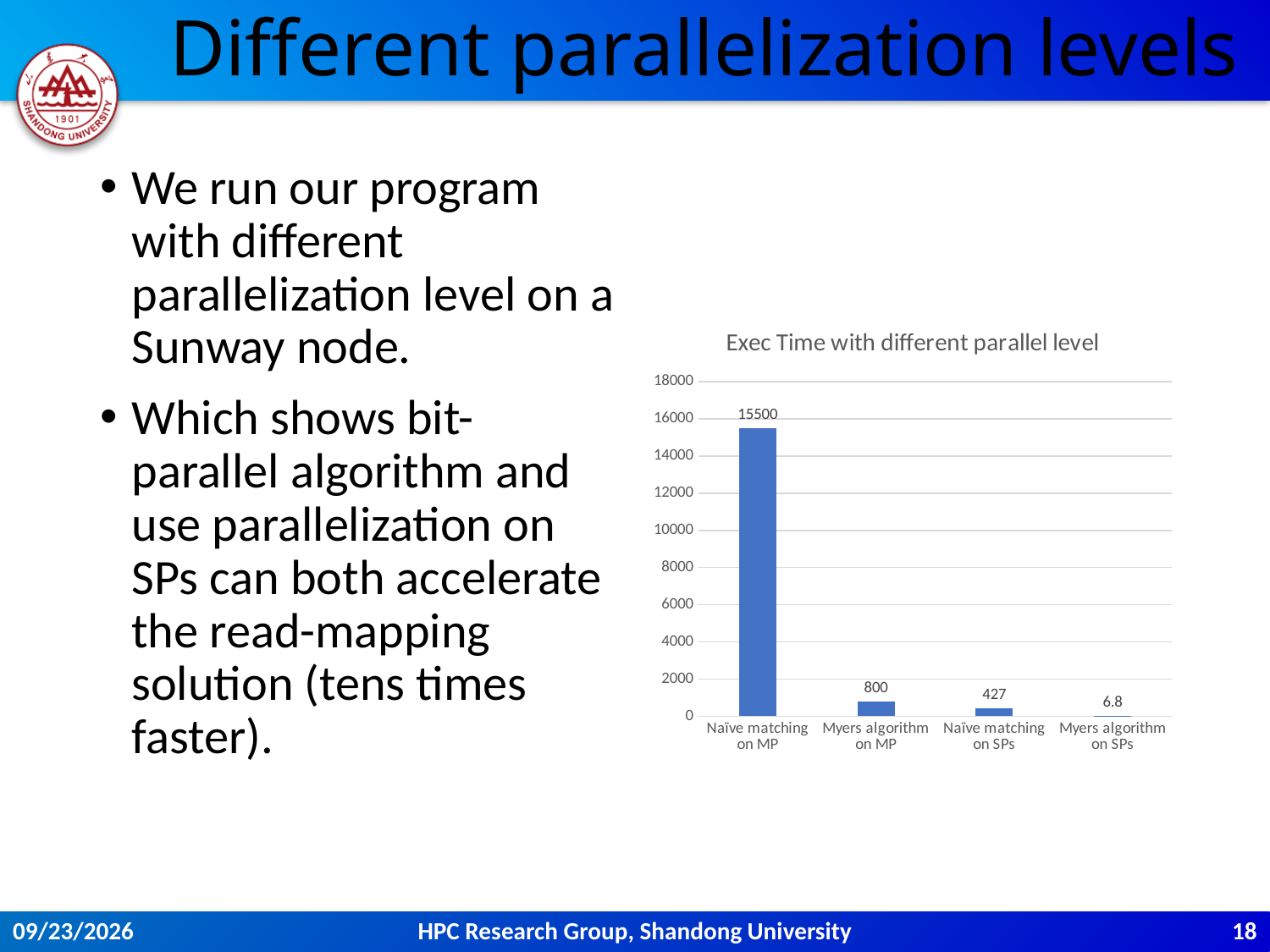
What is the value for Naïve matching on SPs? 427 What is the difference between the values for Myers algorithm on MP and Naïve matching on SPs? 373 Which category has the lowest value? Myers algorithm on SPs What is the value for Myers algorithm on SPs? 6.8 Which category has the highest value? Naïve matching on MP What is the value for Naïve matching on MP? 15500 Which is larger, the value for Myers algorithm on MP or the value for Naïve matching on SPs? Myers algorithm on MP How many categories are shown on the x axis? 4 What is the value for Myers algorithm on MP? 800 What kind of chart is shown on the slide? bar chart Is the value for Naïve matching on MP greater or less than 14000? greater What is the title of the chart? Exec Time with different parallel level